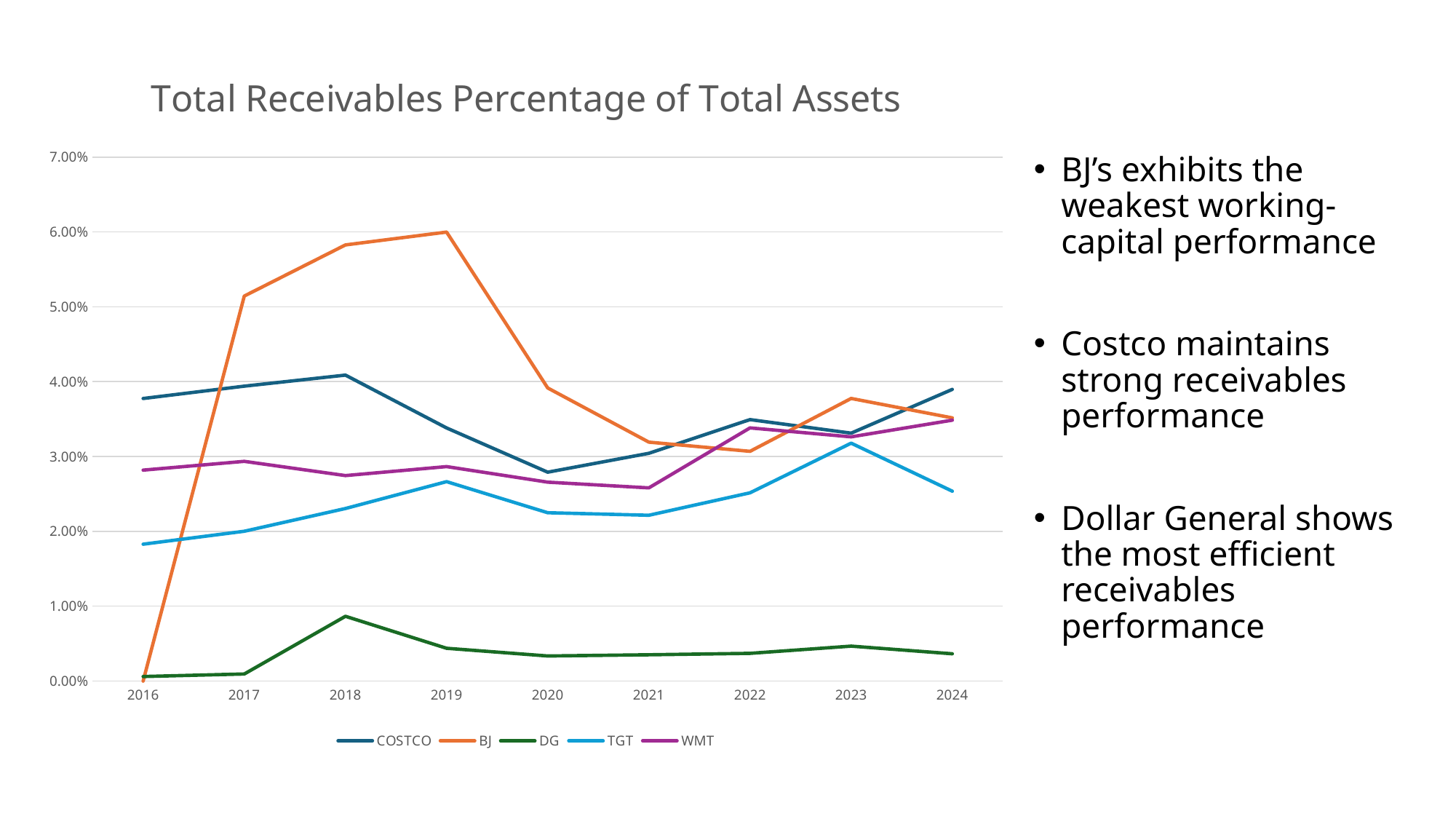
Which series has the lowest value in 2024? DG In 2024, which is larger: the value for TGT or the value for WMT? WMT Is the value for BJ in 2018 greater or less than 5.00%? greater Which series has the highest value in 2019? BJ Is the value for DG in 2018 greater or less than 1.00%? less How many years are shown on the x axis? 9 What kind of chart is shown on the slide? line chart How many series does the legend list? 5 In 2016, which is larger: the value for COSTCO or the value for WMT? COSTCO Which series has the highest value in 2016? COSTCO Is the value for BJ in 2016 greater or less than 1.00%? less Does the BJ line rise or fall from 2019 to 2021? fall